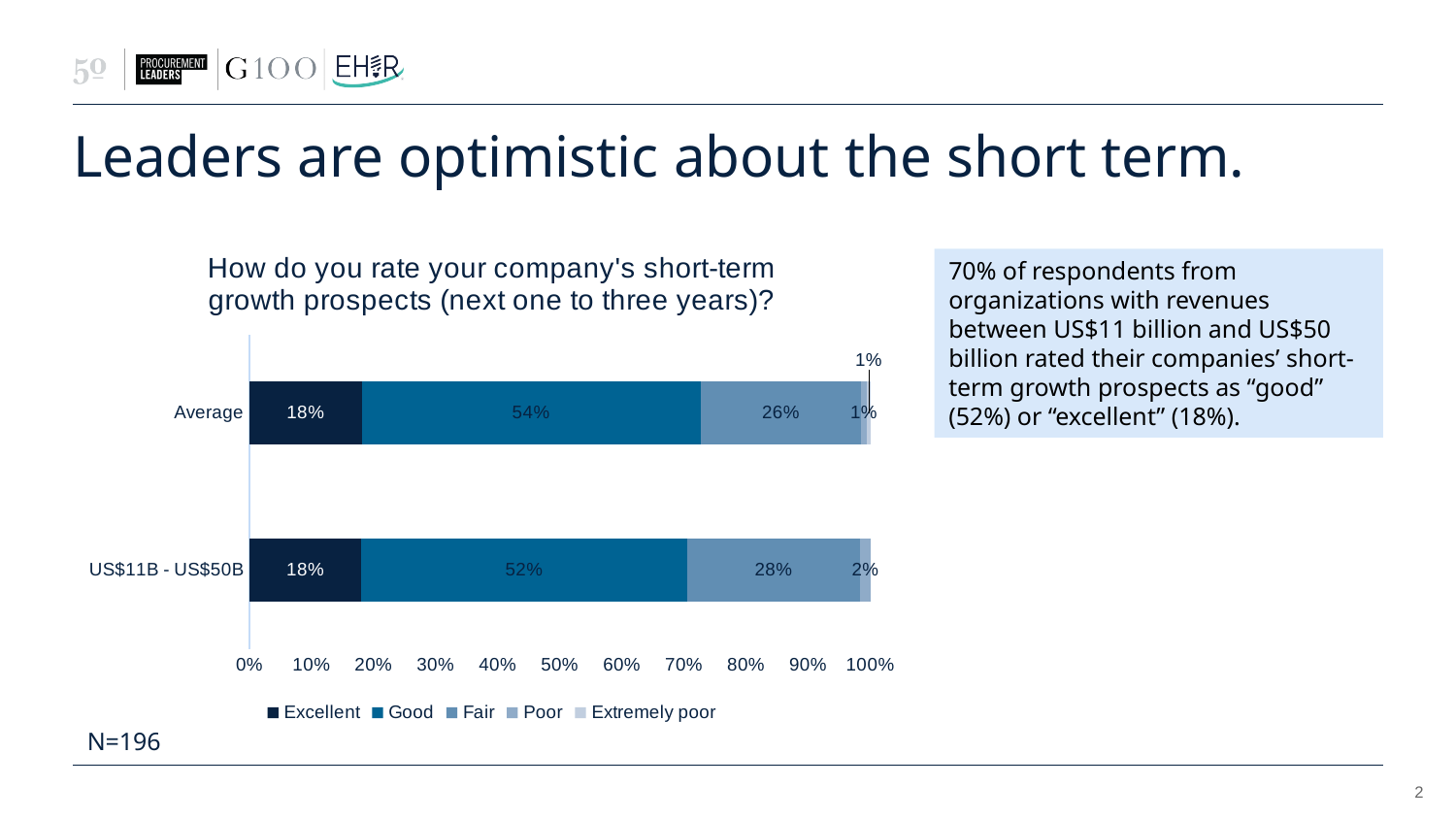
What type of chart is shown on the slide? stacked bar chart What is the Poor value for the US$11B - US$50B category? 2% What is the title of the chart? How do you rate your company's short-term growth prospects (next one to three years)? How many series does the legend list? 5 What is the difference between the Good value for Average and the Good value for US$11B - US$50B? 2% What is the Good value for the Average category? 54% What is the Fair value for the US$11B - US$50B category? 28% Which category has the larger Fair value, Average or US$11B - US$50B? US$11B - US$50B What is the combined Excellent and Good value for the US$11B - US$50B category? 70% What is the Poor value for the Average category? 1% How many categories are shown on the chart? 2 What is the Excellent value for the US$11B - US$50B category? 18%